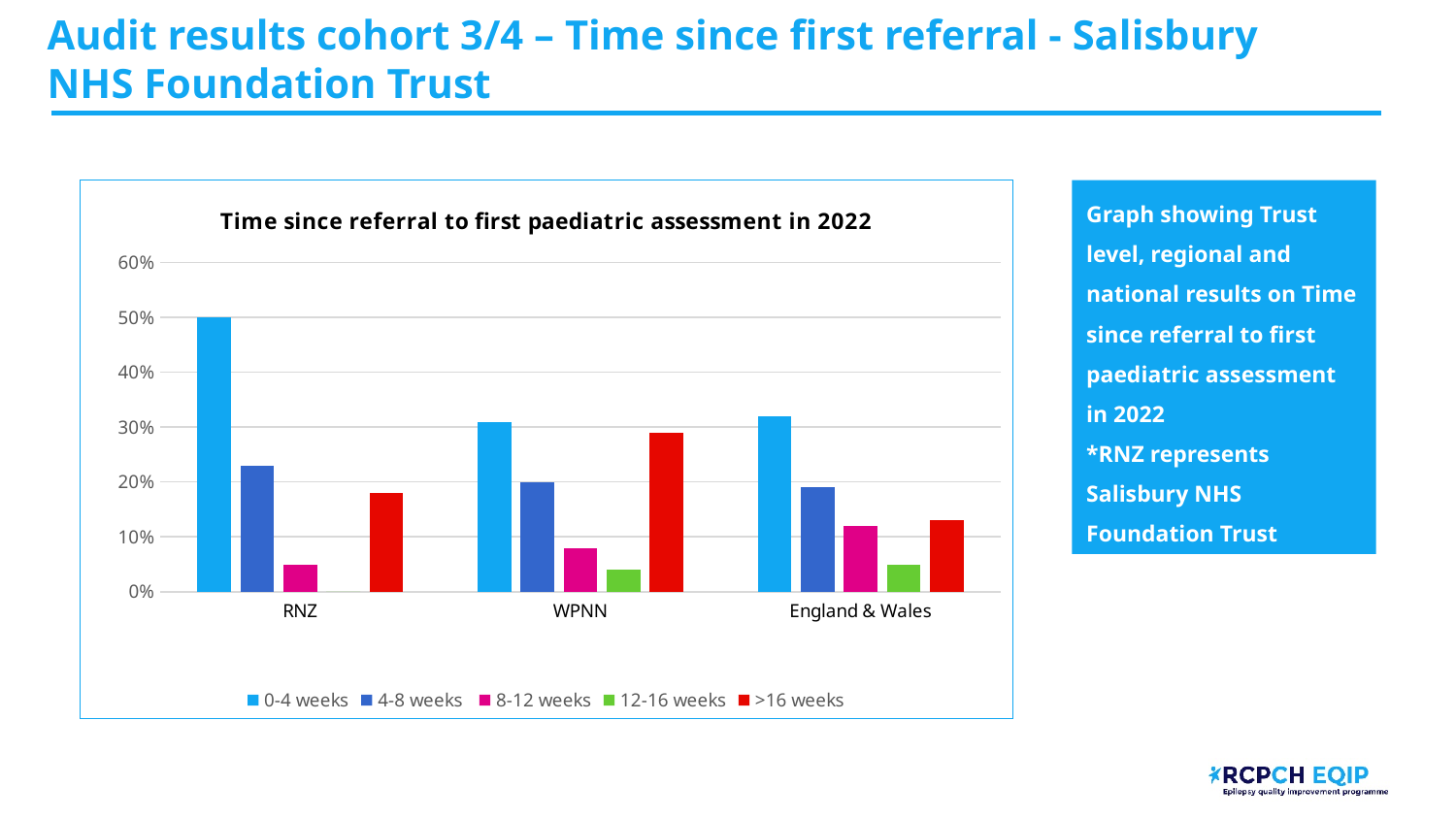
Which is larger, the >16 weeks value for WPNN or for England & Wales? WPNN Is the value for 0-4 weeks for England & Wales greater or less than 30%? greater How many series does the legend list? 5 Which is larger, the 0-4 weeks value for RNZ or for WPNN? RNZ Which category has the highest 0-4 weeks value? RNZ Is the value for 4-8 weeks for RNZ greater or less than 20%? greater What is the value for 0-4 weeks for RNZ? 50% What is the title of the chart? Time since referral to first paediatric assessment in 2022 What kind of chart is shown on the slide? bar chart How many categories are shown on the x axis? 3 Is the value for 8-12 weeks for WPNN greater or less than 10%? less Which category has the lowest >16 weeks value? England & Wales